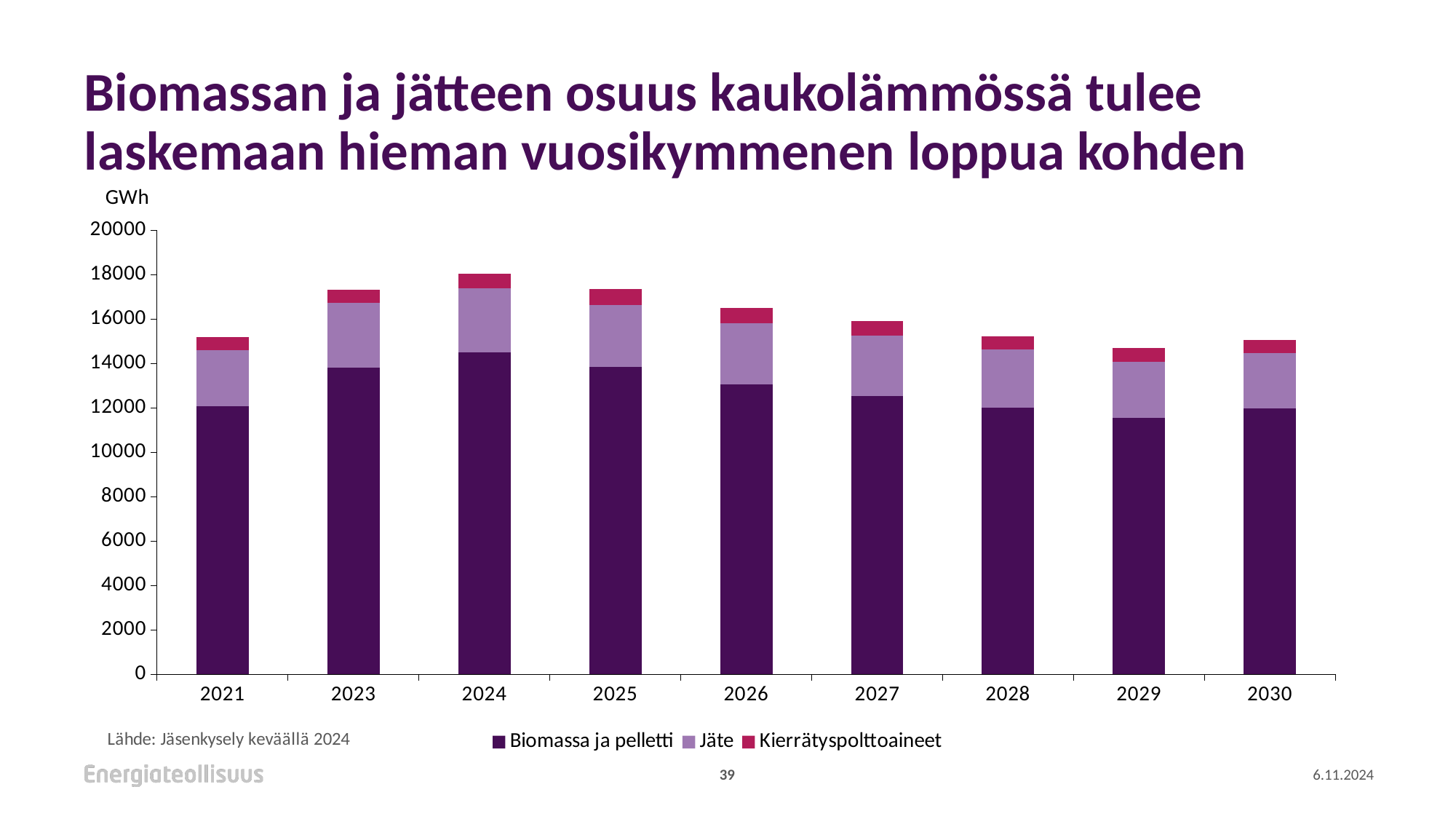
Which year has the highest value for Biomassa ja pelletti? 2024 How many series does the chart legend list? 3 Which year has the highest total stacked bar? 2024 How many years are shown on the x axis of the chart? 9 Do the total stacked values rise or fall from 2024 to 2029? fall Is the value for Biomassa ja pelletti in 2024 greater or less than 14000? greater Which total stacked bar is larger, 2023 or 2028? 2023 What kind of chart is shown on the slide? stacked bar chart Is the value for Biomassa ja pelletti in 2029 greater or less than 12000? less What unit is shown above the y axis of the chart? GWh Is the total stacked value for 2028 greater or less than 16000? less